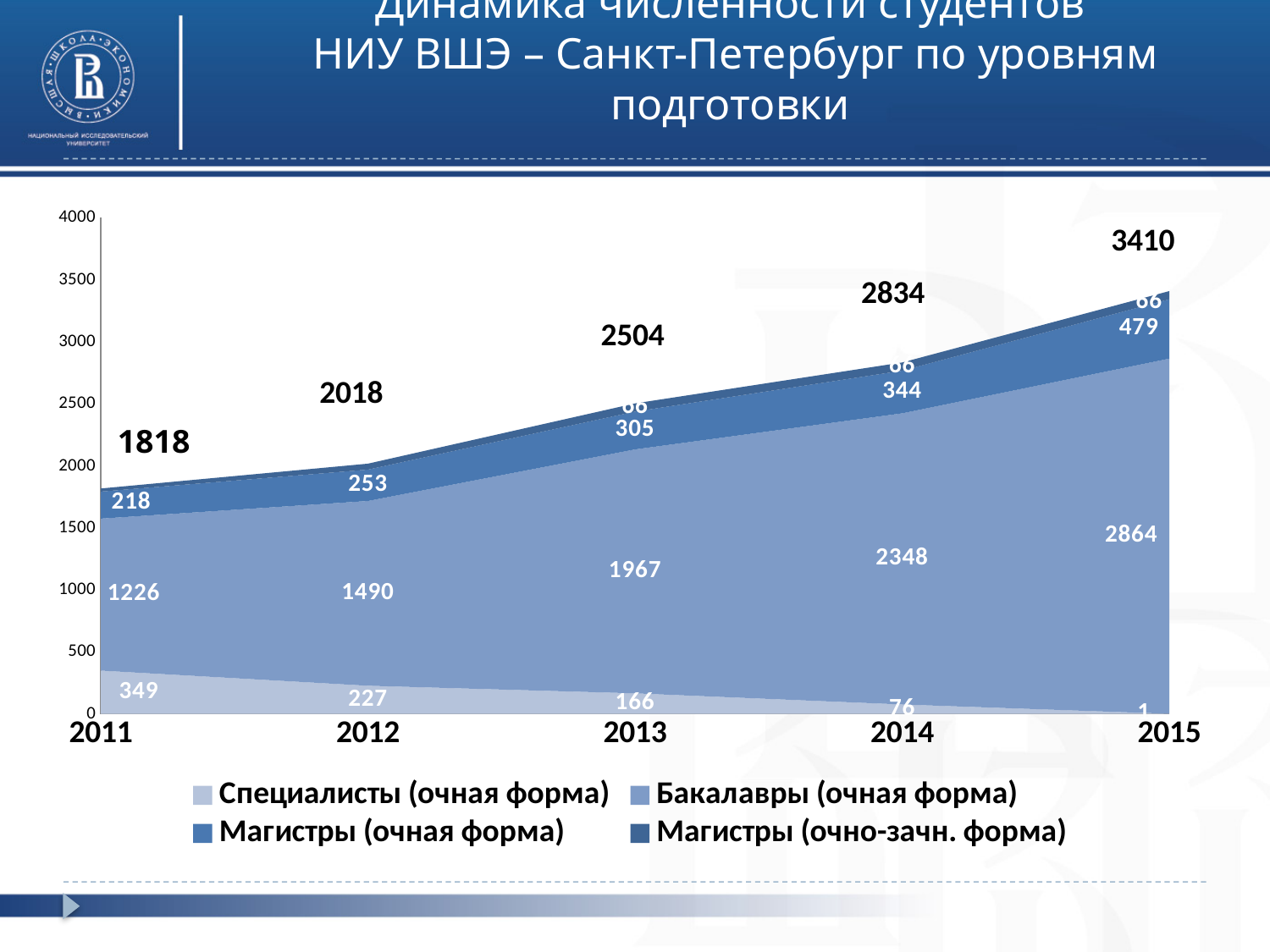
In which year is the value for Специалисты (очная форма) lowest? 2015 In which year is the total number of students highest? 2015 Does the total number of students rise or fall from 2011 to 2015? Rise Which is larger: Магистры (очная форма) in 2012 or Специалисты (очная форма) in 2012? Магистры (очная форма) in 2012 What is the difference between the Бакалавры (очная форма) values in 2015 and 2014? 516 What is the value for Бакалавры (очная форма) in 2013? 1967 What is the value for Специалисты (очная форма) in 2011? 349 What is the value for Магистры (очная форма) in 2015? 479 What type of chart is shown on the slide? Stacked area chart What is the total number of students shown for 2014? 2834 How many series does the legend list? 4 How many years are shown on the x axis? 5